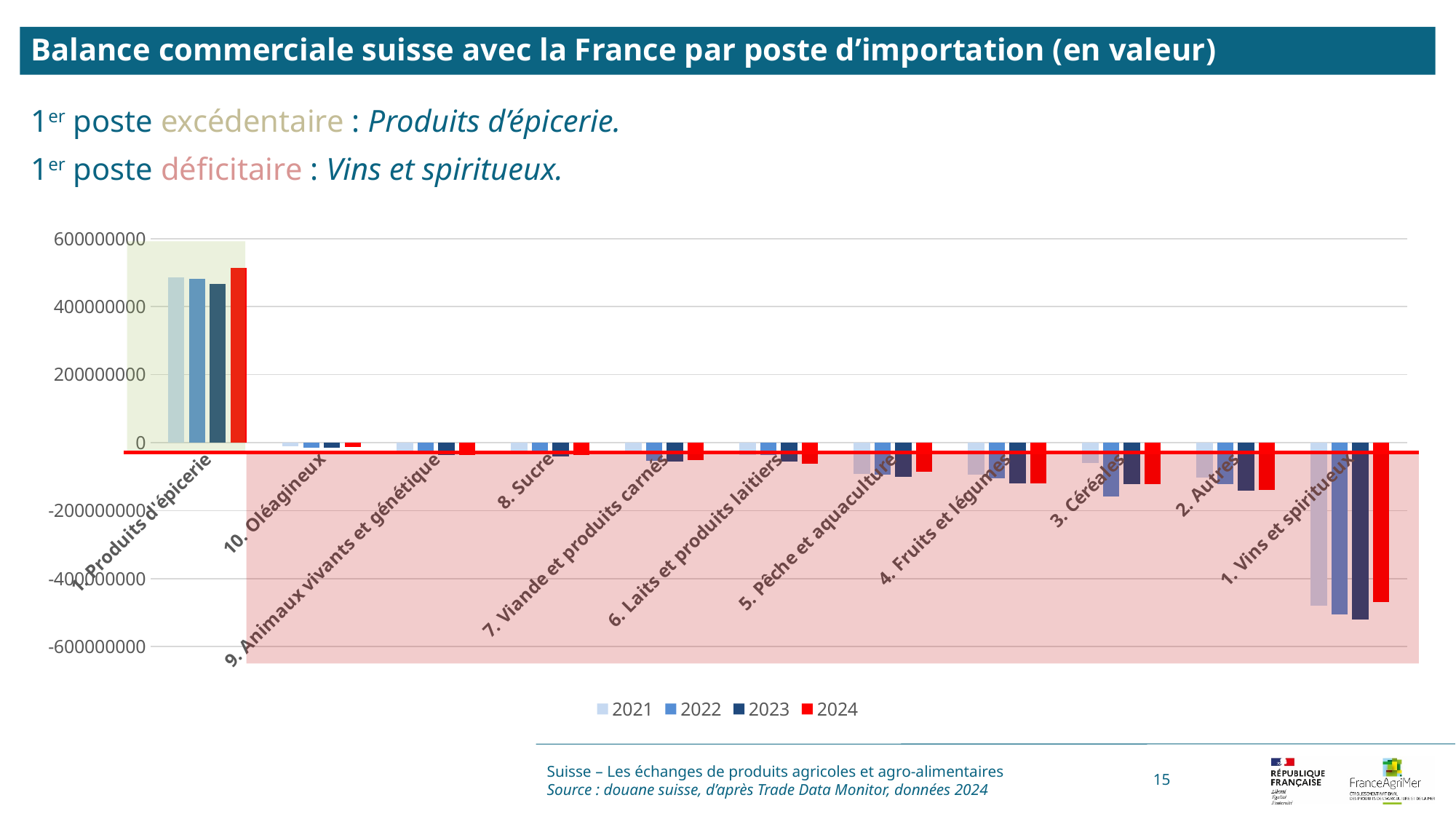
Is the 2021 value for Vins et spiritueux greater or less than -600000000? greater Which years are listed in the chart legend? 2021, 2022, 2023, 2024 What kind of chart is shown on the slide? bar chart Which colour represents the 2024 series in the chart? red For Produits d'épicerie, which year has the larger value, 2023 or 2024? 2024 Is the 2024 value for Céréales greater or less than -200000000? greater Is the 2024 value for Produits d'épicerie greater or less than 400000000? greater Which category has the lowest (most negative) values in the chart? Vins et spiritueux Which category has the highest (most positive) values in the chart? Produits d'épicerie How many series does the chart legend list? 4 How many import categories are shown on the x axis of the chart? 11